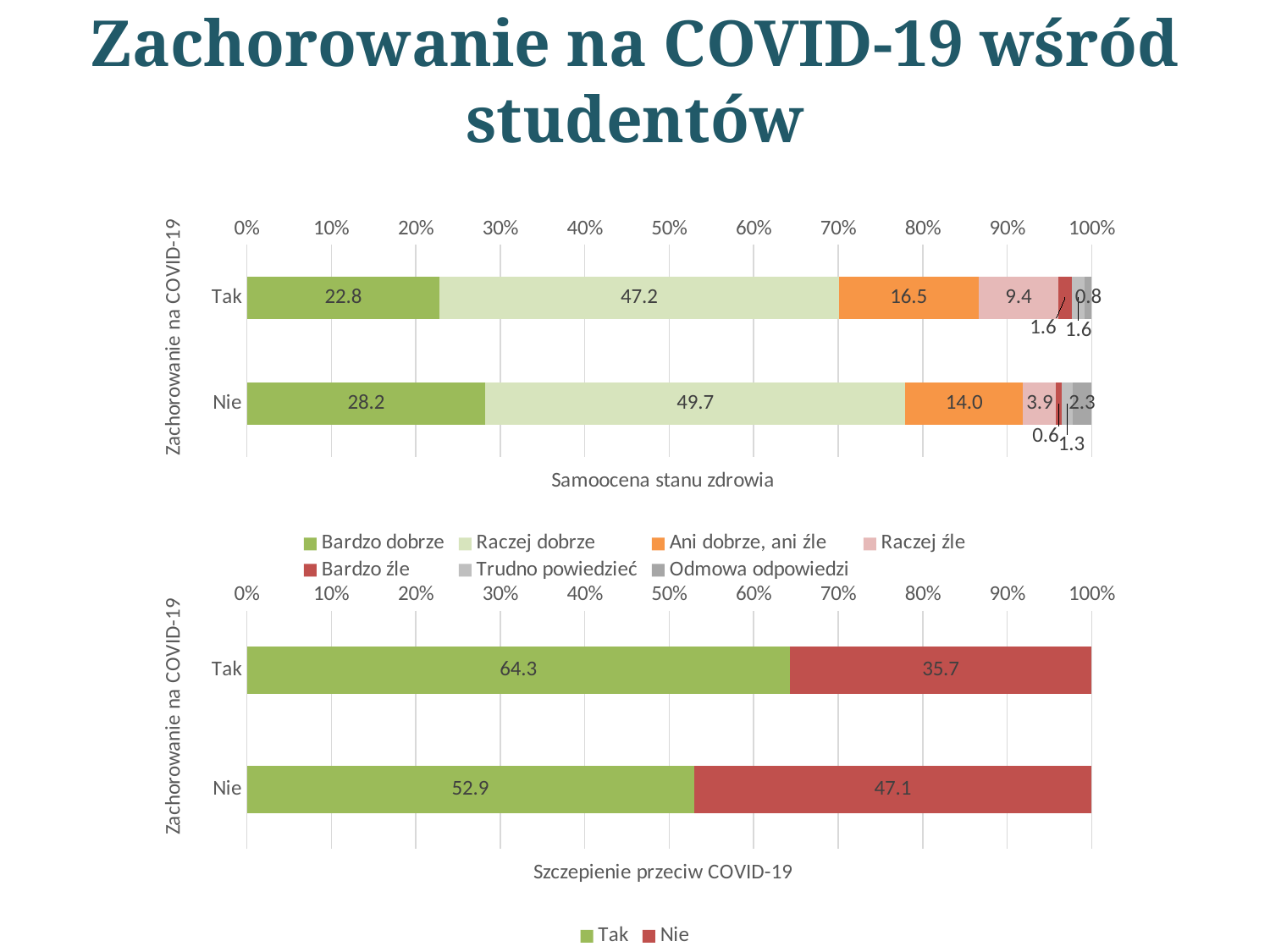
How many categories are shown on the y axis of the bottom chart (Szczepienie przeciw COVID-19)? 2 In the top chart (Samoocena stanu zdrowia), what is the value of 'Bardzo dobrze' for the 'Nie' category? 28.2 In the top chart (Samoocena stanu zdrowia), which category has the larger 'Bardzo dobrze' value, 'Tak' or 'Nie'? Nie What is the y-axis title of the top chart (Samoocena stanu zdrowia)? Zachorowanie na COVID-19 In the bottom chart (Szczepienie przeciw COVID-19), what is the 'Tak' value for the 'Nie' category? 52.9 What kind of chart is the bottom chart (Szczepienie przeciw COVID-19)? Stacked bar chart In the top chart (Samoocena stanu zdrowia), what is the value of 'Ani dobrze, ani źle' for the 'Nie' category? 14.0 In the top chart (Samoocena stanu zdrowia), what is the value of 'Raczej dobrze' for the 'Tak' category? 47.2 In the bottom chart (Szczepienie przeciw COVID-19), what is the 'Nie' value for the 'Tak' category? 35.7 In the bottom chart (Szczepienie przeciw COVID-19), what is the difference between the 'Tak' values for the 'Tak' and 'Nie' categories? 11.4 In the top chart (Samoocena stanu zdrowia), what is the difference between the 'Raczej źle' values for 'Tak' and 'Nie'? 5.5 How many series does the legend of the top chart (Samoocena stanu zdrowia) list? 7